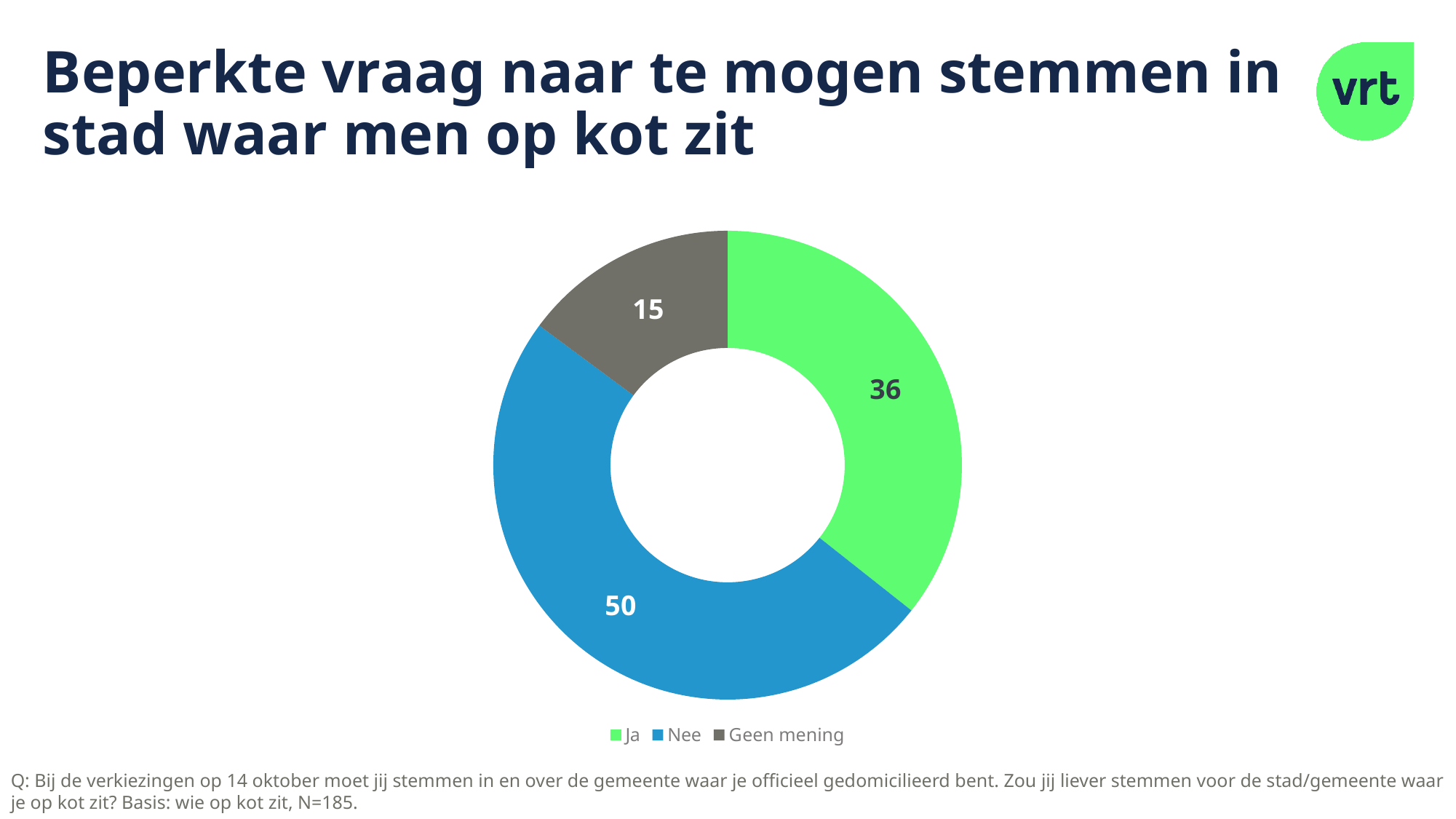
What is the difference between the values for "Nee" and "Ja"? 14 How many categories does the chart show? 3 Which colour represents "Nee" in the chart? Blue Which category has the largest value? Nee What is the value for "Geen mening"? 15 What is the title of the slide? Beperkte vraag naar te mogen stemmen in stad waar men op kot zit What is the difference between the values for "Ja" and "Geen mening"? 21 Which category has the smallest value? Geen mening Which is larger, the value for "Ja" or the value for "Geen mening"? Ja What is the value for "Nee"? 50 What is the value for "Ja"? 36 What kind of chart is shown on the slide? Doughnut chart